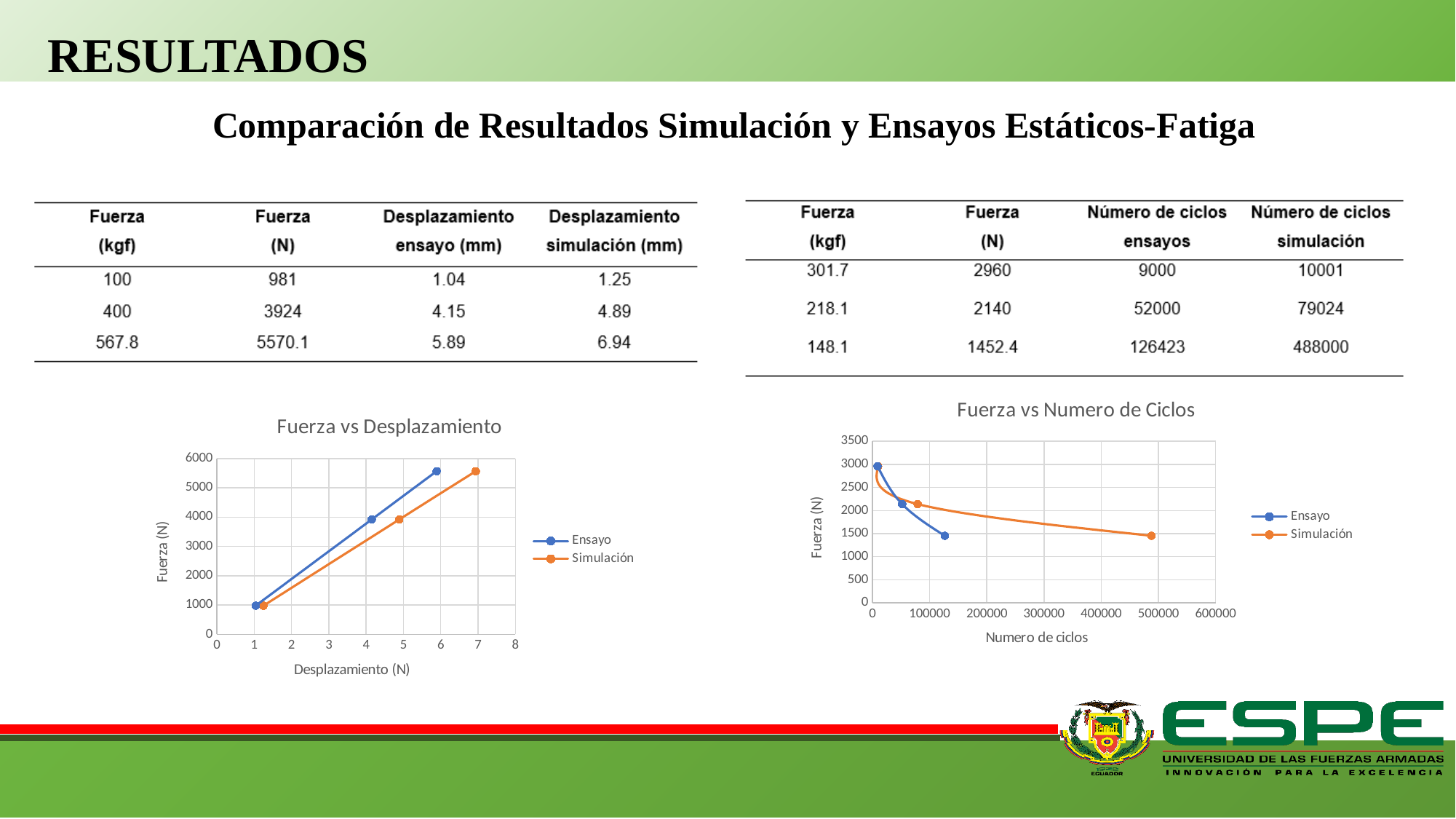
In the 'Fuerza vs Numero de Ciclos' chart, do the force values rise or fall as the number of cycles increases? fall In the 'Fuerza vs Desplazamiento' chart, is the highest force value of the Ensayo series greater or less than 5000? greater What kind of chart is the 'Fuerza vs Desplazamiento' chart? line chart In the 'Fuerza vs Desplazamiento' chart, at the highest force level, which series shows the larger displacement, Ensayo or Simulación? Simulación What kind of chart is the 'Fuerza vs Numero de Ciclos' chart? line chart What is the x-axis label of the 'Fuerza vs Desplazamiento' chart? Desplazamiento (N) How many series does the legend of the 'Fuerza vs Desplazamiento' chart list? 2 In the 'Fuerza vs Desplazamiento' chart, how many data points does the Ensayo series have? 3 In the 'Fuerza vs Numero de Ciclos' chart, which colour is used for the Simulación series? orange In the 'Fuerza vs Numero de Ciclos' chart, which series reaches the larger number of cycles, Ensayo or Simulación? Simulación In the 'Fuerza vs Desplazamiento' chart, do the values rise or fall as displacement increases? rise In the 'Fuerza vs Numero de Ciclos' chart, is the number of cycles at the last Simulación point greater or less than 400000? greater